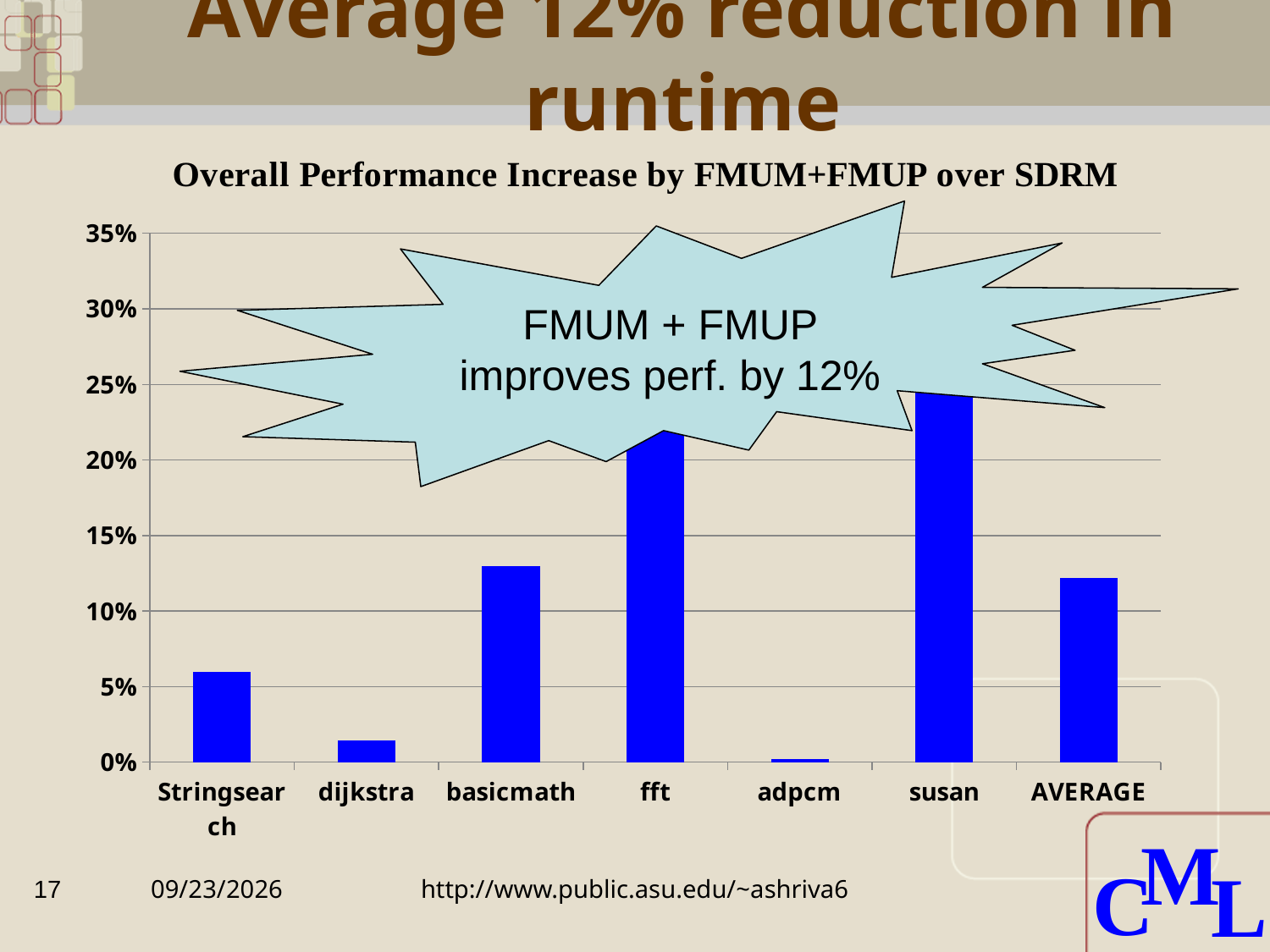
Which category has the lowest bar? adpcm Is the value for fft greater or less than 20%? greater What does the callout shape over the chart say? FMUM + FMUP improves perf. by 12% What kind of chart is shown on the slide? bar chart What is the title of the chart? Overall Performance Increase by FMUM+FMUP over SDRM Which category has the highest bar? susan Which is larger, the value for basicmath or the value for Stringsearch? basicmath Is the value for dijkstra greater or less than 5%? less Is the value for basicmath greater or less than 10%? greater Which is larger, the value for fft or the value for AVERAGE? fft How many benchmark categories are plotted on the x axis? 7